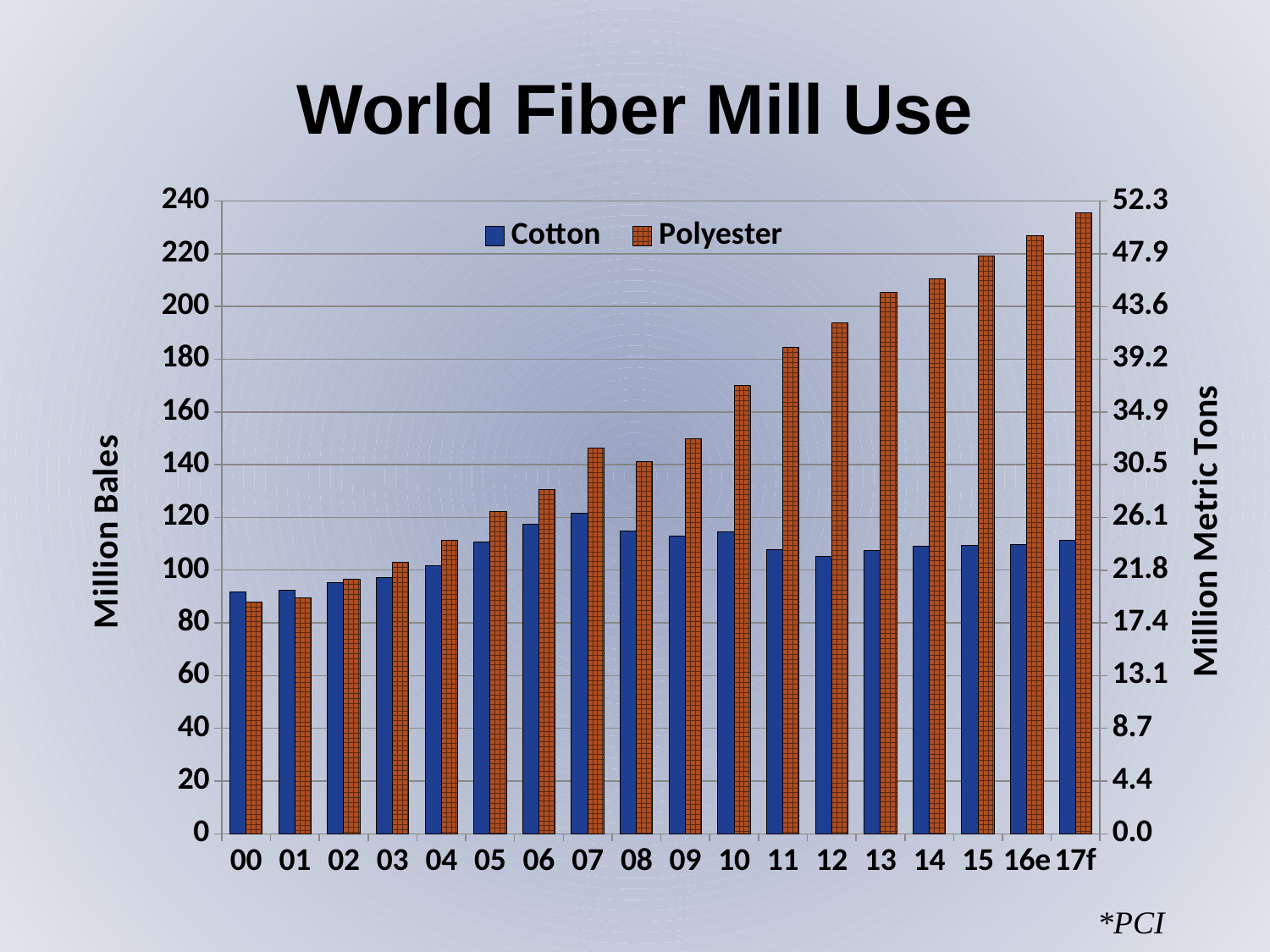
Do the Polyester values generally rise or fall from 00 to 17f? rise In which year is the Cotton value highest? 07 What type of chart is shown on the slide? bar chart Is the Cotton value for 00 greater or less than 100 million bales? less Is the Cotton value for 12 greater or less than 100 million bales? greater How many year categories are shown on the x axis? 18 In which year is the Polyester value highest? 17f Which is larger, the Cotton value for 07 or the Cotton value for 12? 07 What is the label of the left vertical axis? Million Bales What is the title of the chart? World Fiber Mill Use How many series does the legend list? 2